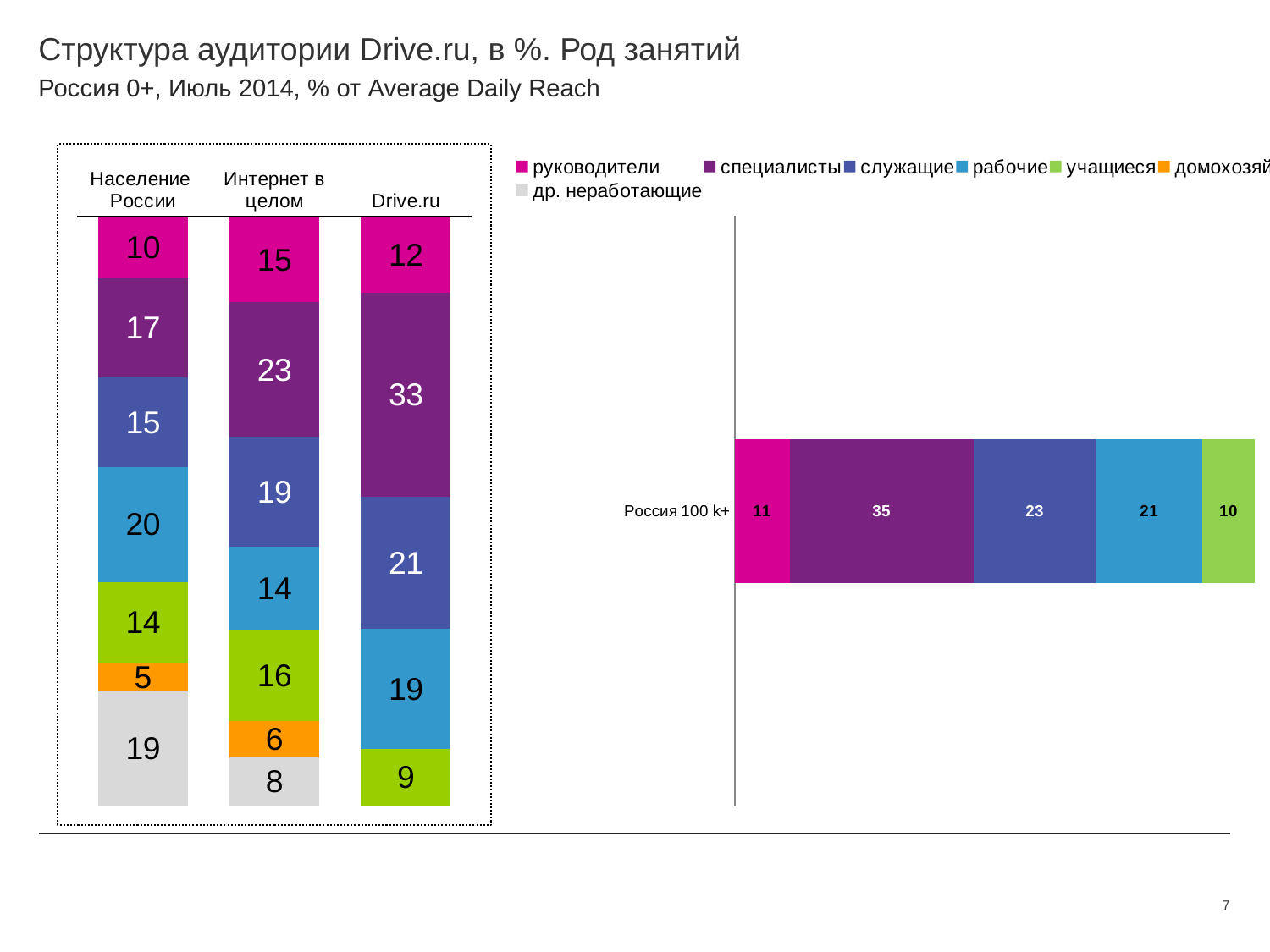
In the left stacked bar chart, which segment is the smallest in the Население России bar? домохозяйки How many bars (categories) does the left stacked bar chart show? 3 In the left stacked bar chart, which is larger: the руководители value for Интернет в целом or for Drive.ru? Интернет в целом In the left stacked bar chart, which segment is the largest in the Drive.ru bar? специалисты What type of chart is shown on the right side of the slide? Stacked bar chart In the left stacked bar chart, what is the value of the специалисты segment for Drive.ru? 33 In the right chart, what is the total of the Россия 100 k+ stacked bar? 100 In the right chart, what is the value of the специалисты segment for Россия 100 k+? 35 In the left stacked bar chart, what is the value of the учащиеся segment for Интернет в целом? 16 In the left stacked bar chart, what is the value of the рабочие segment for Население России? 20 In the left stacked bar chart, what is the difference between the специалисты values for Drive.ru and Интернет в целом? 10 In the right chart, what is the value of the учащиеся segment for Россия 100 k+? 10